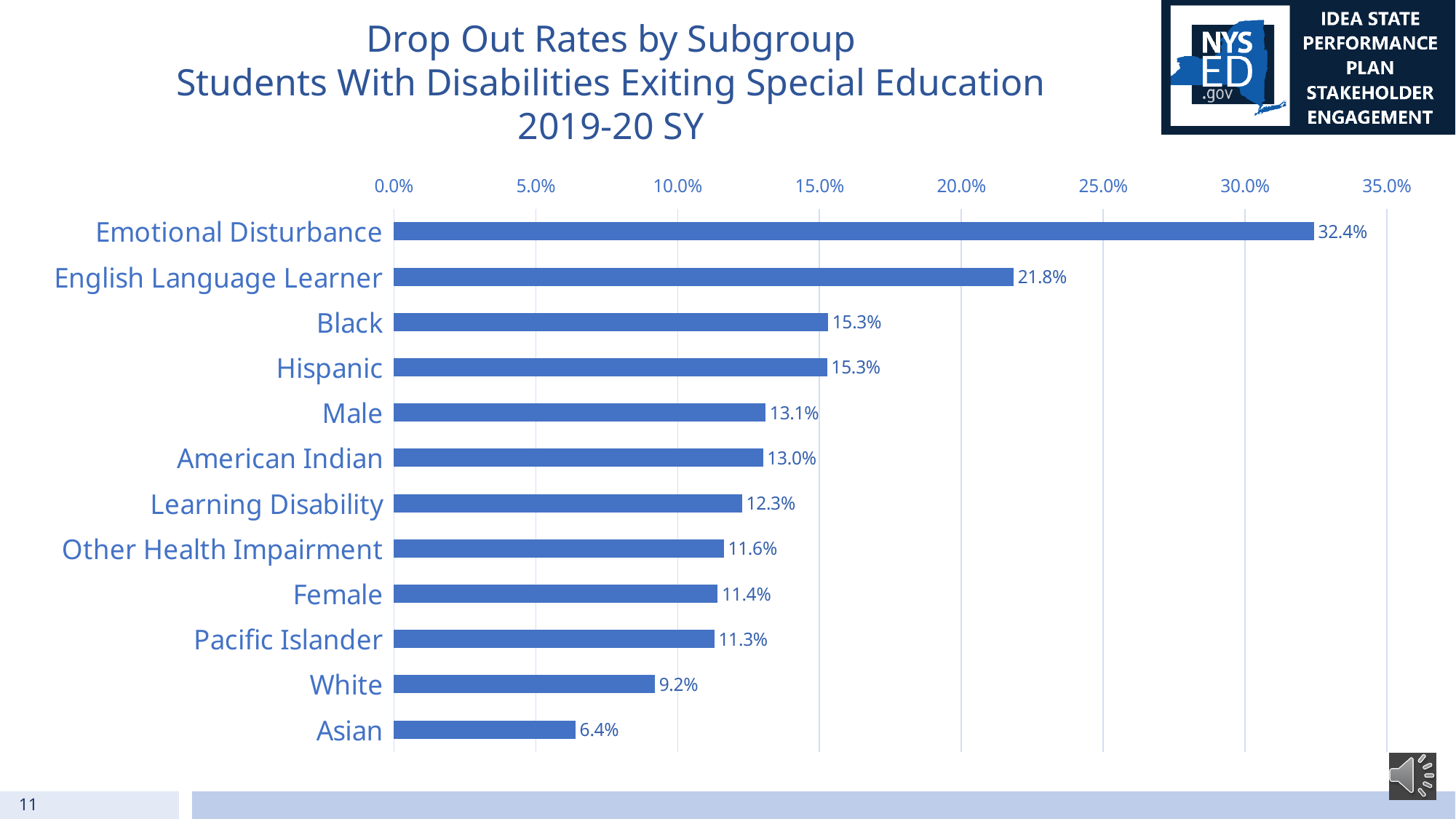
What is the drop out rate for White students? 9.2% Which has a higher drop out rate, Learning Disability or Pacific Islander? Learning Disability What is the difference between the drop out rates for Male and Female? 1.7% What is the difference between the drop out rates for Emotional Disturbance and English Language Learner? 10.6% Which subgroup has the lowest drop out rate? Asian What kind of chart is shown on the slide? Bar chart How many subgroups are shown in the chart? 12 Which subgroup has the highest drop out rate? Emotional Disturbance What is the drop out rate for Emotional Disturbance? 32.4% Is the drop out rate for Black students greater or less than 20.0%? less What is the drop out rate for Other Health Impairment? 11.6% What is the drop out rate for English Language Learner? 21.8%